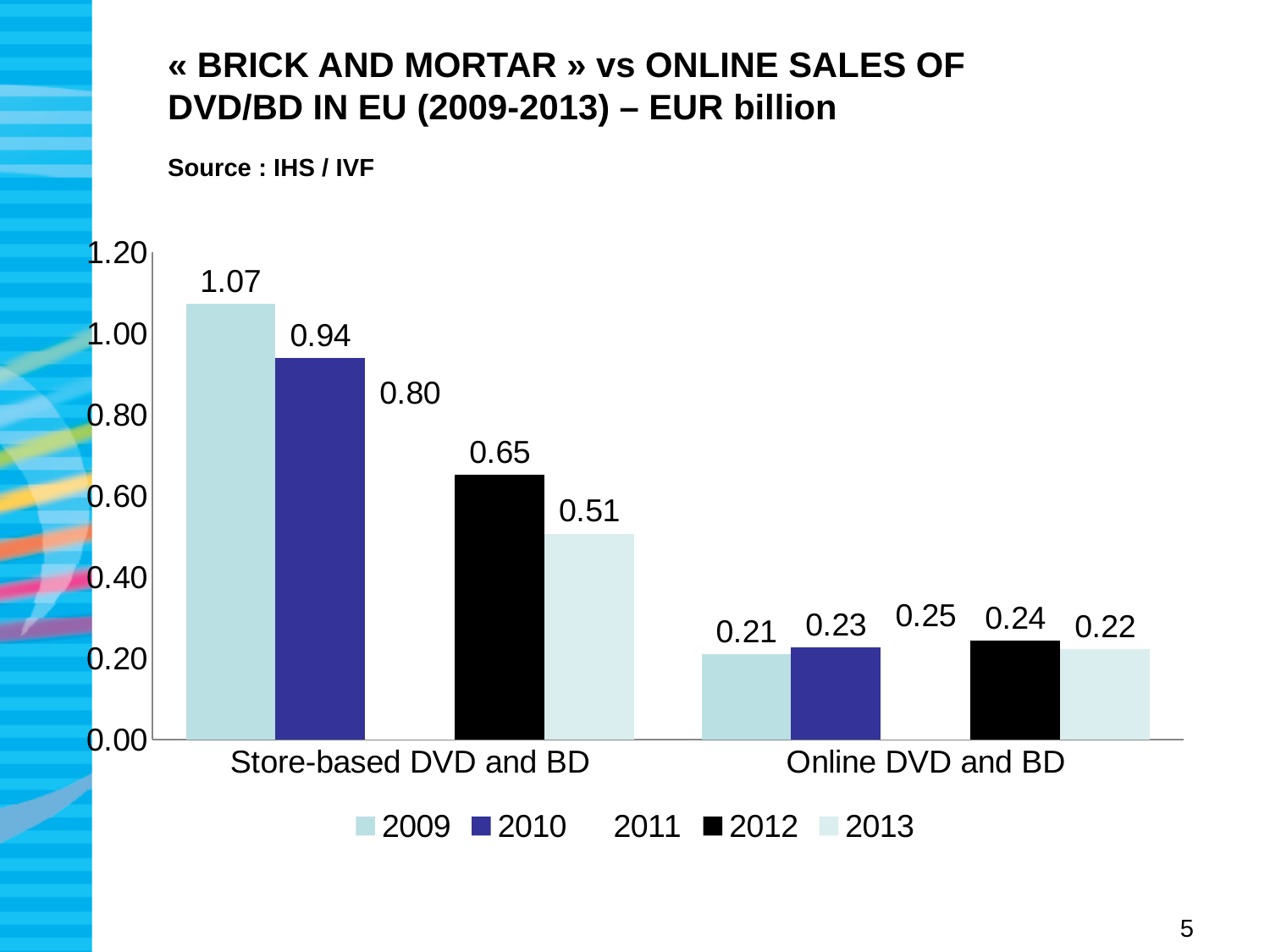
What was the value for Store-based DVD and BD in 2009? 1.07 Which year had the lowest value for Online DVD and BD? 2009 What kind of chart is shown on the slide? Bar chart Which is larger: Store-based DVD and BD in 2012 or Online DVD and BD in 2012? Store-based DVD and BD in 2012 What is the difference between the Store-based DVD and BD values for 2009 and 2013? 0.56 Which year had the highest value for Store-based DVD and BD? 2009 How many series does the legend list? 5 What was the value for Online DVD and BD in 2011? 0.25 How many categories are shown on the x axis? 2 Do the Store-based DVD and BD values rise or fall from 2009 to 2013? Fall What was the value for Store-based DVD and BD in 2013? 0.51 What was the value for Online DVD and BD in 2012? 0.24